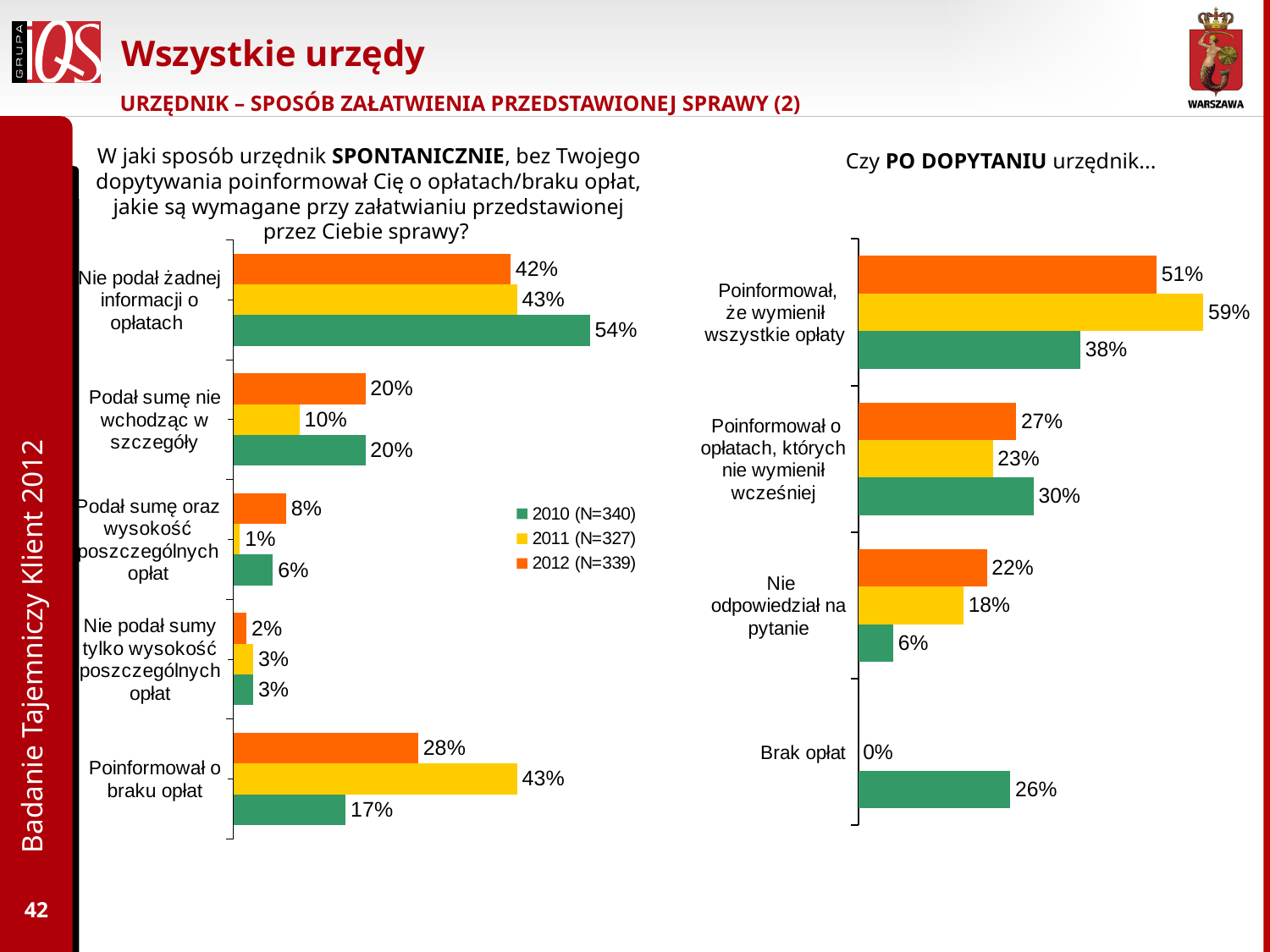
In the left chart (SPONTANICZNIE), what is the 2011 value for 'Poinformował o braku opłat'? 43% How many series does the legend list? 3 In the left chart (SPONTANICZNIE), what is the 2010 value for 'Nie podał żadnej informacji o opłatach'? 54% In the right chart (PO DOPYTANIU), which year has the highest value for 'Poinformował, że wymienił wszystkie opłaty'? 2011 In the right chart (PO DOPYTANIU), what is the difference between the 2012 and 2010 values for 'Nie odpowiedział na pytanie'? 16 percentage points How many categories does the left chart (SPONTANICZNIE) show? 5 In the right chart (PO DOPYTANIU), what is the 2012 value for 'Nie odpowiedział na pytanie'? 22% In the left chart (SPONTANICZNIE), which year has the lowest value for 'Podał sumę oraz wysokość poszczególnych opłat'? 2011 In the left chart (SPONTANICZNIE), what is the difference between the 2011 and 2012 values for 'Poinformował o braku opłat'? 15 percentage points What type of chart is the right chart (PO DOPYTANIU)? Bar chart In the right chart (PO DOPYTANIU), for 'Poinformował o opłatach, których nie wymienił wcześniej', is the 2010 value larger or the 2011 value? 2010 In the right chart (PO DOPYTANIU), what is the 2010 value for 'Brak opłat'? 26%